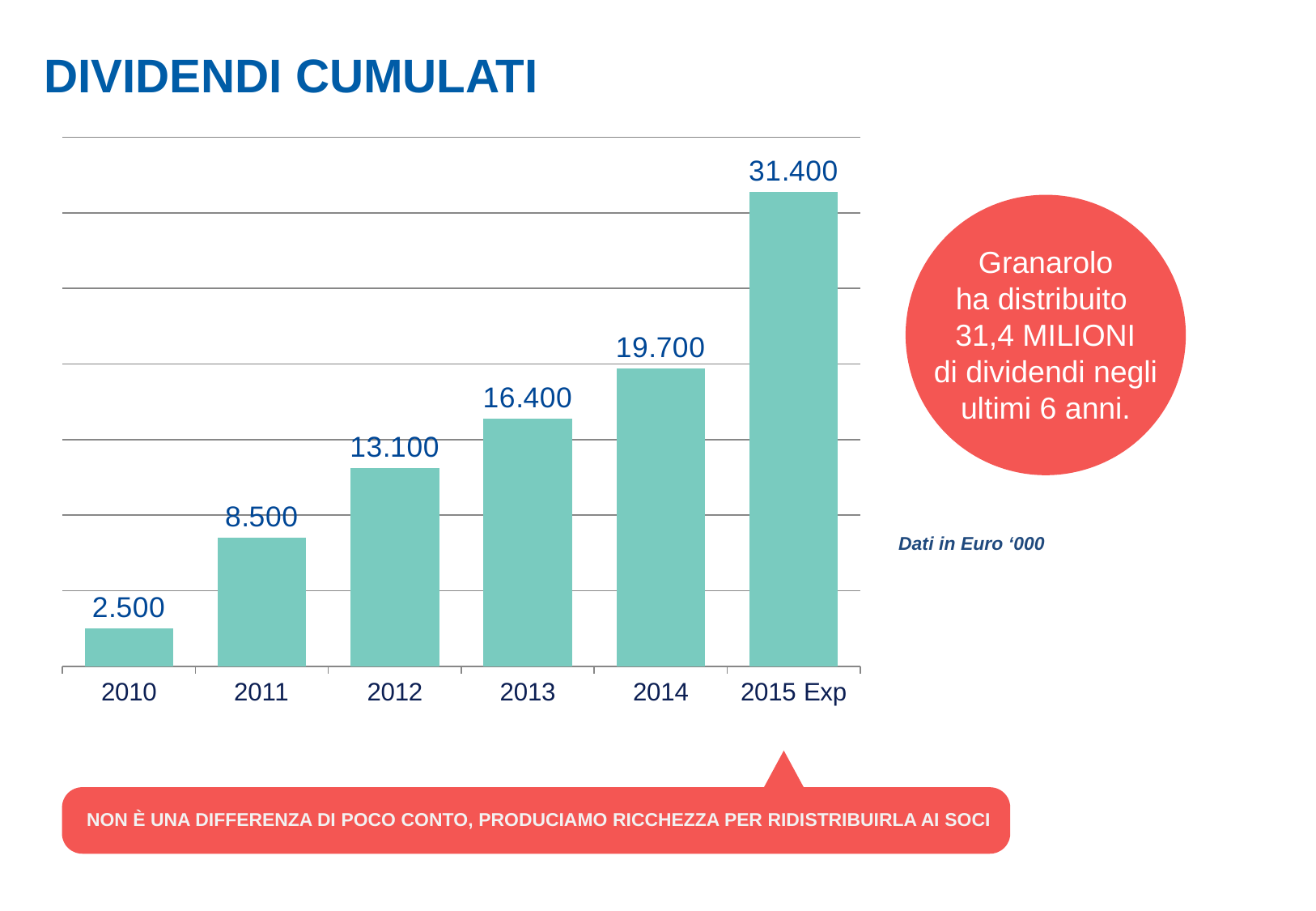
What is the difference between the values for 2015 Exp and 2014? 11.700 What is the difference between the values for 2012 and 2011? 4.600 Which category has the lowest value? 2010 Which category has the highest value? 2015 Exp What is the title of the chart? DIVIDENDI CUMULATI How many categories are shown on the x axis? 6 Do the values rise or fall from 2010 to 2015 Exp? rise What is the value for 2010? 2.500 What is the value for 2015 Exp? 31.400 Which is larger, the value for 2013 or the value for 2012? 2013 What kind of chart is shown on the slide? bar chart What is the value for 2013? 16.400